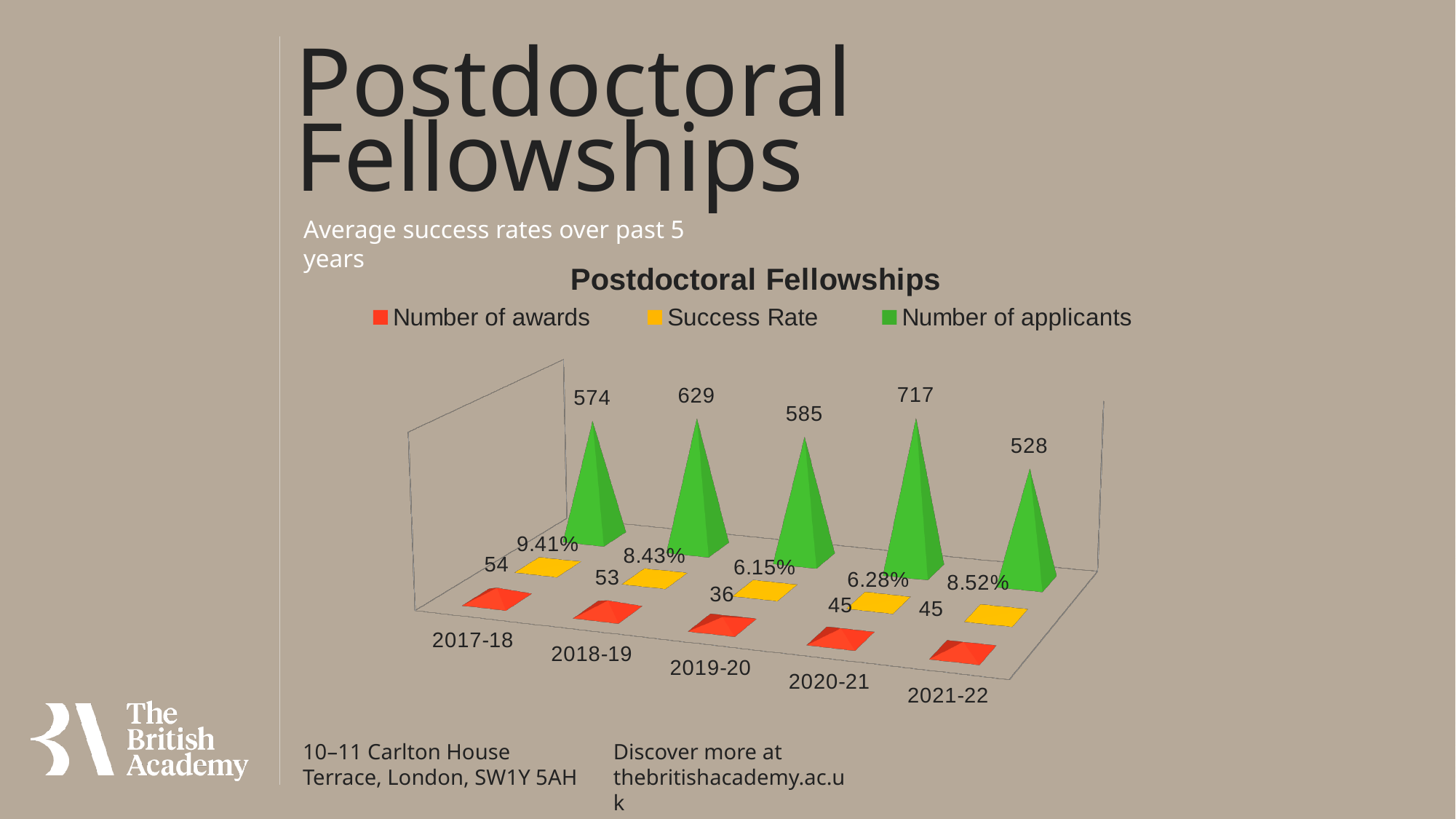
Which year has the lowest Success Rate? 2019-20 What is the Success Rate for 2017-18? 9.41% What is the Number of applicants for 2020-21? 717 What is the Number of applicants for 2021-22? 528 What is the difference in Number of applicants between 2020-21 and 2021-22? 189 Which year has the highest Number of applicants? 2020-21 Which year has the lowest Number of awards? 2019-20 How many series does the legend list? 3 How many years are shown on the x axis? 5 What is the Number of awards for 2019-20? 36 Which is larger, the Number of applicants in 2018-19 or in 2019-20? 2018-19 What is the title of the chart? Postdoctoral Fellowships